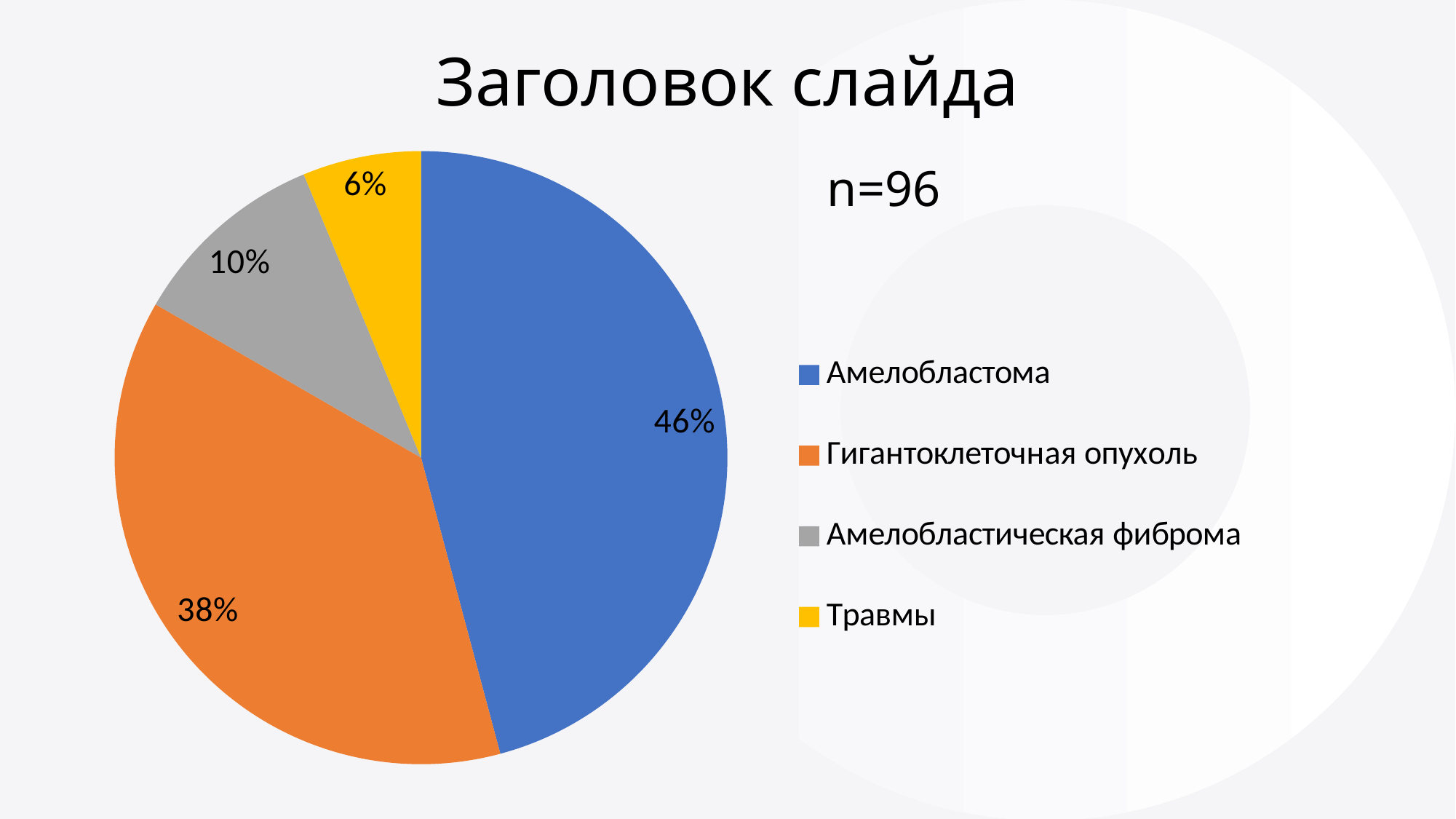
What share of the pie does Амелобластическая фиброма have? 10% Which is larger: the share for Амелобластическая фиброма or the share for Травмы? Амелобластическая фиброма Which category has the smallest slice of the pie? Травмы What share of the pie does Гигантоклеточная опухоль have? 38% How many categories does the pie chart have? 4 What is the difference in percentage points between Амелобластома and Гигантоклеточная опухоль? 8 What type of chart is shown on the slide? pie chart What sample size (n) is stated on the slide? n=96 Which category has the largest slice of the pie? Амелобластома What share of the pie does Травмы have? 6% What colour is the slice for Гигантоклеточная опухоль? orange